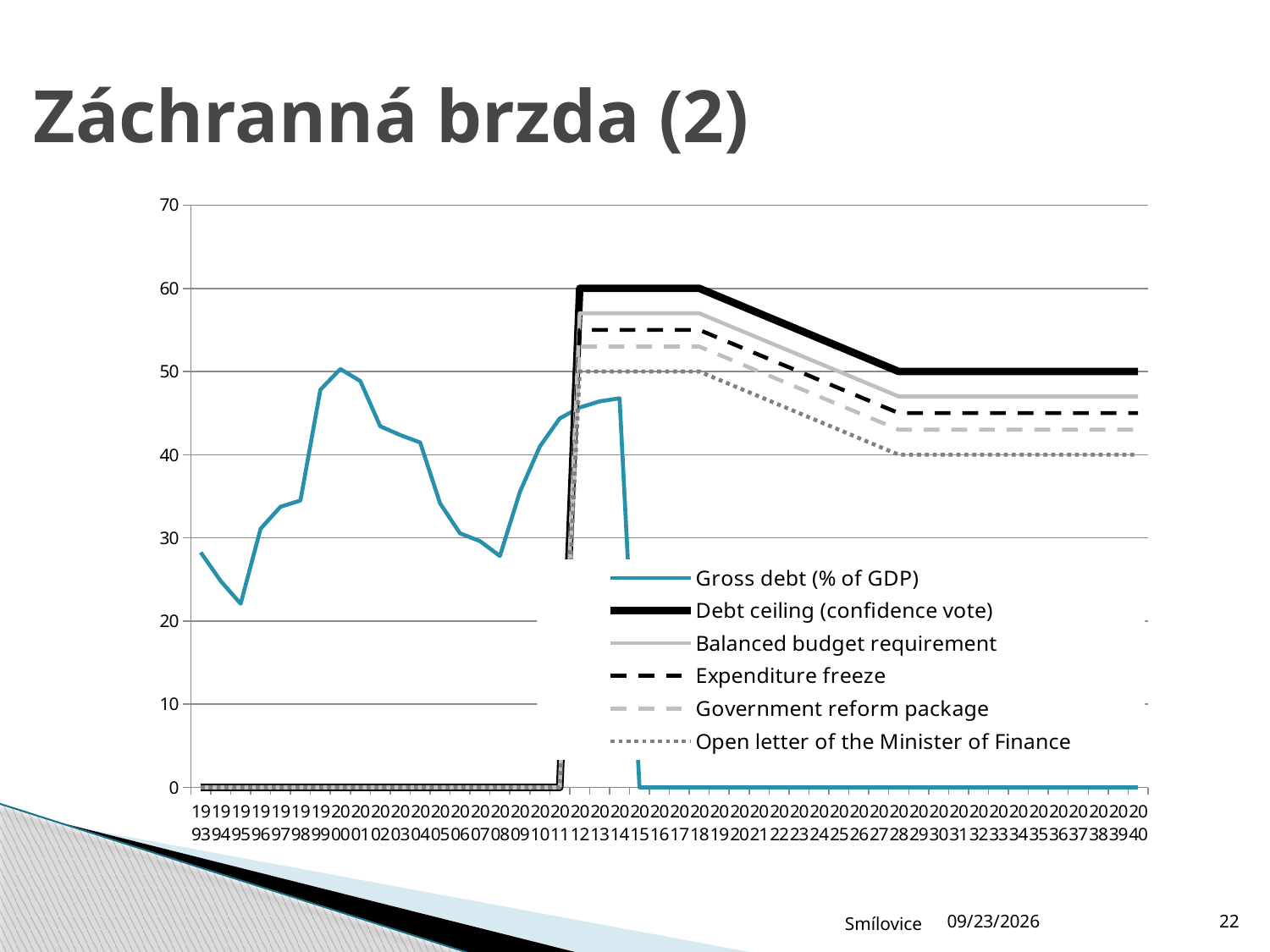
What is the value of the Open letter of the Minister of Finance line in 2015? 50 Which series has the highest value in 2020? Debt ceiling (confidence vote) What is the value of the Debt ceiling (confidence vote) line in 2015? 60 What is the value of the Debt ceiling (confidence vote) line in 2035? 50 Which legend entry is drawn as the thick solid black line? Debt ceiling (confidence vote) What is the title of the slide containing the chart? Záchranná brzda (2) How many series does the legend list? 6 What kind of chart is shown on the slide? line chart What is the value of the Open letter of the Minister of Finance line in 2035? 40 Is the Gross debt (% of GDP) value in 2000 greater or less than 40? greater Is the Gross debt (% of GDP) value in 1995 greater or less than 30? less Does the Debt ceiling (confidence vote) line rise or fall between 2018 and 2028? fall